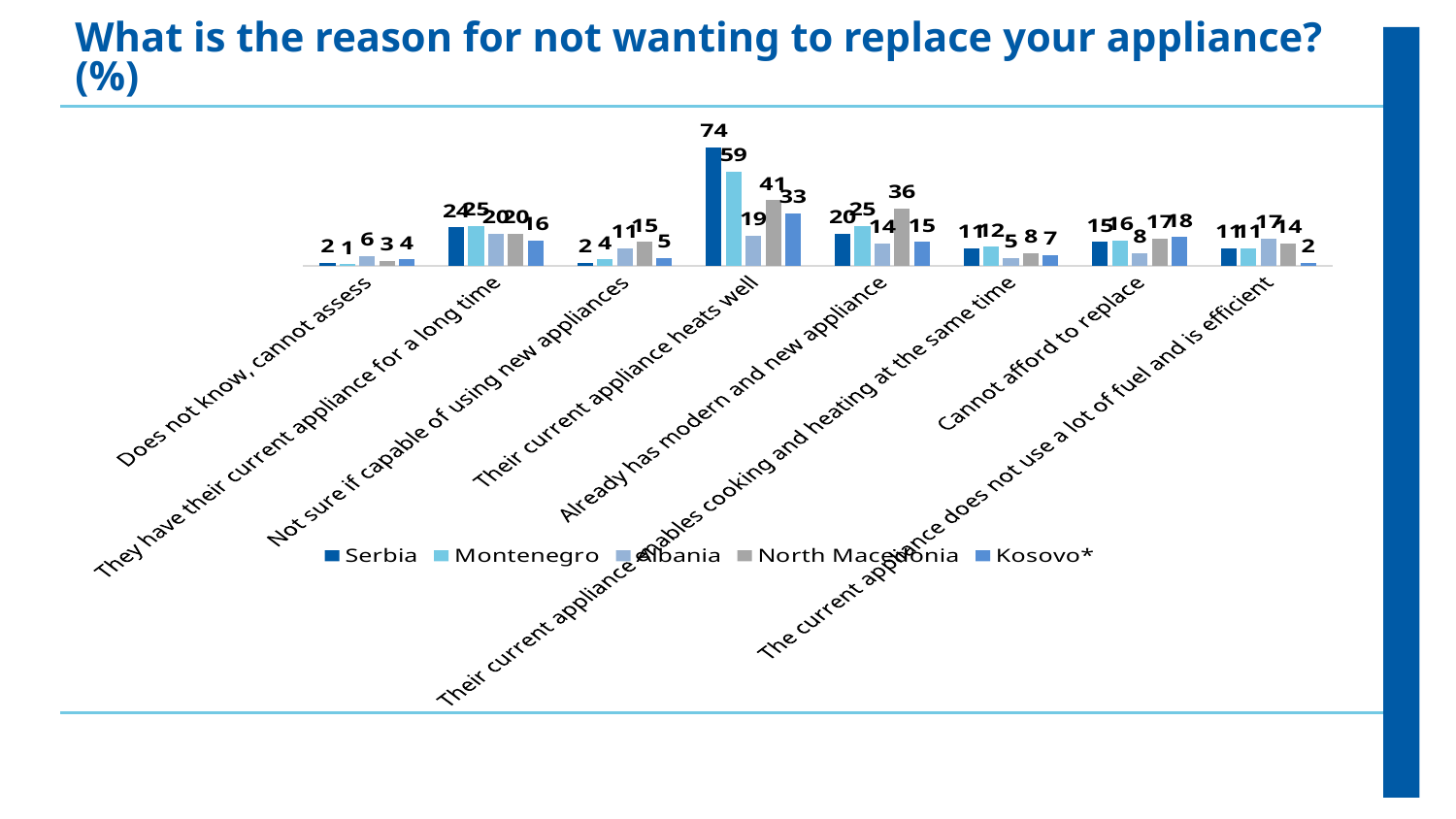
Which country has the highest value in the category "Their current appliance heats well"? Serbia How many reason categories are shown on the x axis? 8 What is the value for Serbia in the category "Their current appliance heats well"? 74 What is the difference between Serbia and Montenegro in the category "Their current appliance heats well"? 15 In the category "Not sure if capable of using new appliances", which is larger: Albania or North Macedonia? North Macedonia What is the value for North Macedonia in the category "Already has modern and new appliance"? 36 What is the value for Montenegro in the category "Their current appliance heats well"? 59 How many series does the legend list? 5 What kind of chart is shown on the slide? Bar chart What is the value for Kosovo* in the category "The current appliance does not use a lot of fuel and is efficient"? 2 Which country has the lowest value in the category "Their current appliance heats well"? Albania What is the value for Albania in the category "Does not know, cannot assess"? 6